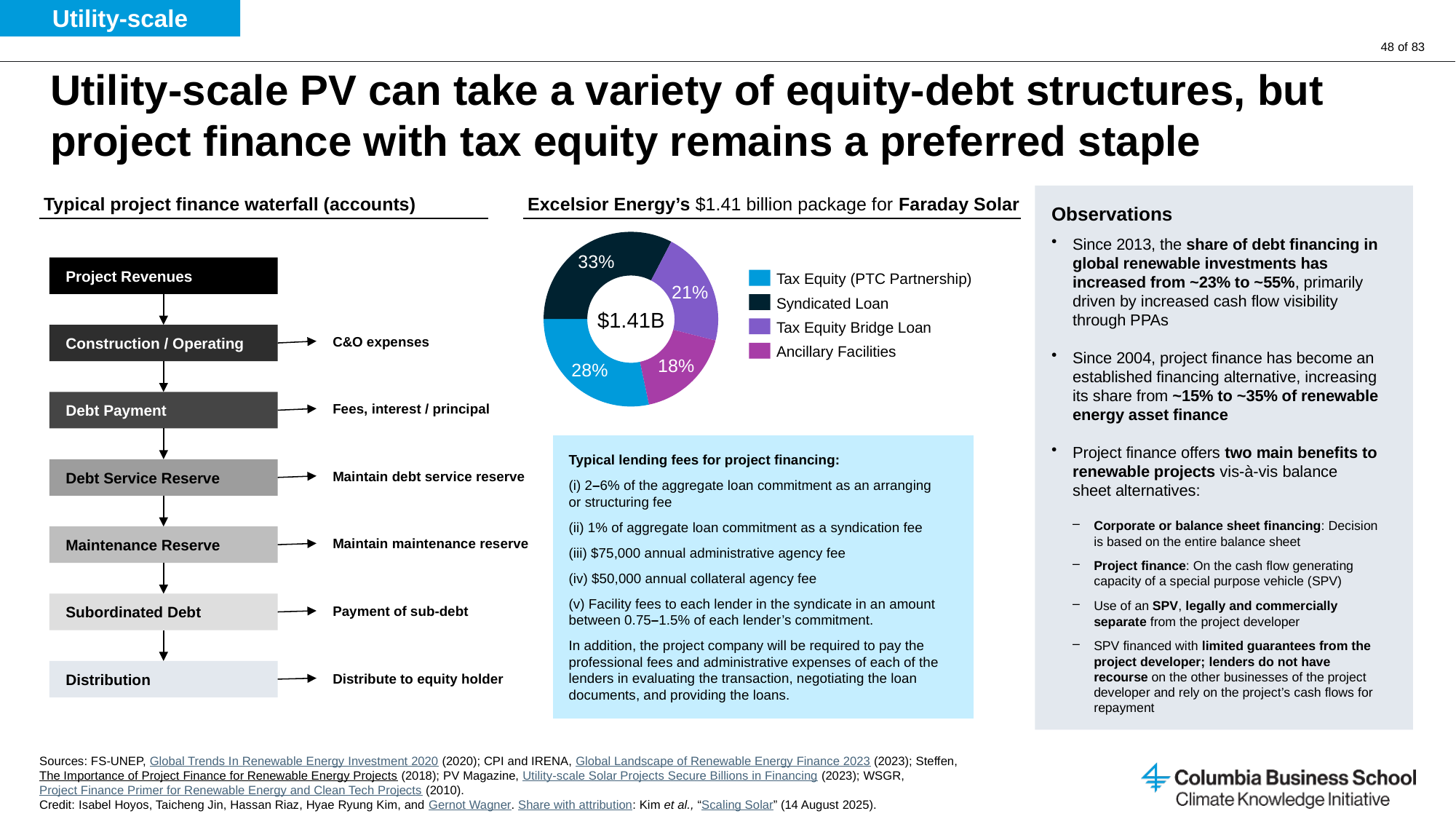
What kind of chart is used to show Excelsior Energy's $1.41 billion package for Faraday Solar? Donut (pie) chart How many components does the legend of the Faraday Solar package chart list? 4 In the Faraday Solar package chart, what share is Syndicated Loan? 33% In the Faraday Solar package chart, what colour represents Syndicated Loan? Dark navy In the Faraday Solar package chart, what share is Ancillary Facilities? 18% What value is printed in the center of the Faraday Solar package donut chart? $1.41B In the Faraday Solar package chart, which component has the smallest share? Ancillary Facilities In the Faraday Solar package chart, what share is Tax Equity Bridge Loan? 21% In the Faraday Solar package chart, which component has the largest share? Syndicated Loan In the Faraday Solar package chart, which is larger: Tax Equity (PTC Partnership) or Tax Equity Bridge Loan? Tax Equity (PTC Partnership) In the Faraday Solar package chart, how many percentage points larger is Syndicated Loan than Ancillary Facilities? 15 percentage points In the Faraday Solar package chart, what share is Tax Equity (PTC Partnership)? 28%